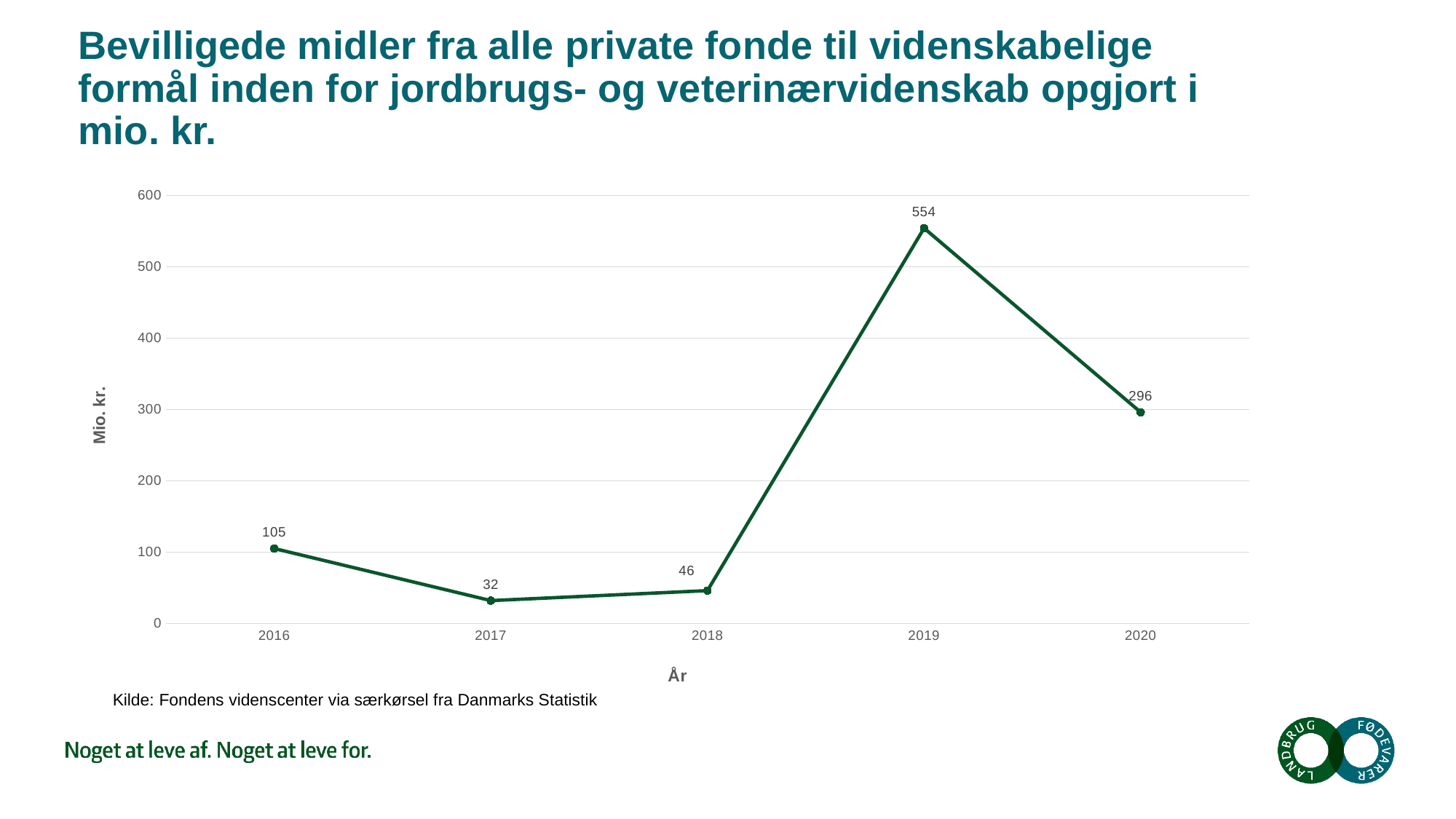
Is the value for 2020 greater or less than 200? greater What is the value for 2019? 554 Which is larger, the value for 2016 or the value for 2018? 2016 Which year has the lowest value? 2017 Which year has the highest value? 2019 What is the difference between the values for 2016 and 2018? 59 What is the value for 2020? 296 How many years are plotted on the chart? 5 What is the label of the y axis? Mio. kr. What is the value for 2017? 32 What kind of chart is shown on the slide? line chart What is the difference between the values for 2019 and 2020? 258